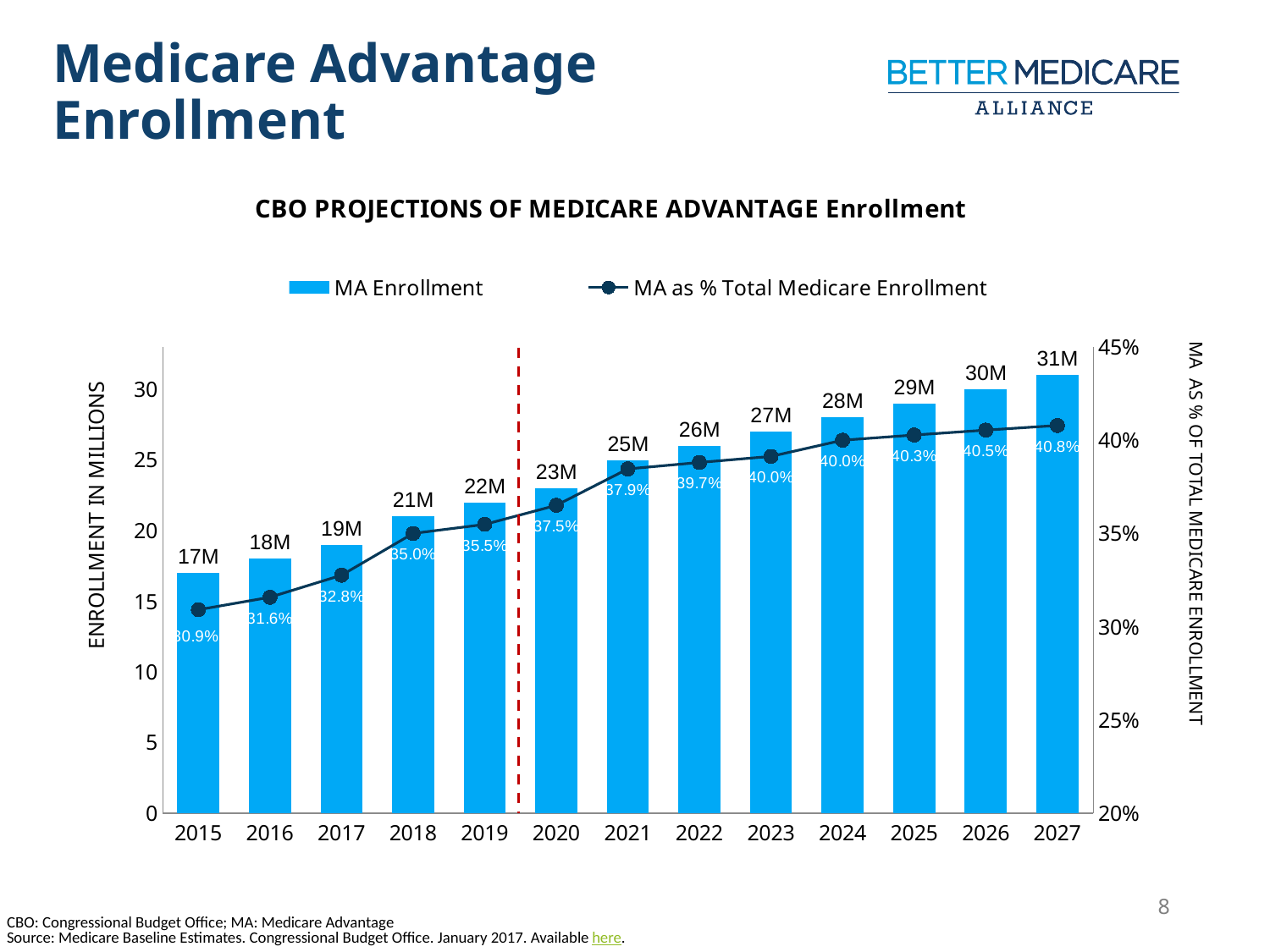
What is the MA as % Total Medicare Enrollment value for 2020? 37.5% What is the difference in MA Enrollment between 2027 and 2015? 14M Does MA Enrollment rise or fall from 2015 to 2027? Rise What is the MA as % Total Medicare Enrollment value for 2017? 32.8% Which year has the lowest MA as % Total Medicare Enrollment? 2015 Which year has the highest MA Enrollment? 2027 Which year has a higher MA Enrollment, 2018 or 2022? 2022 How many series does the legend list? 2 How many years are shown on the x axis? 13 What is the MA Enrollment value for 2015? 17M What kind of chart is this? Combined bar and line chart What is the MA Enrollment value for 2027? 31M